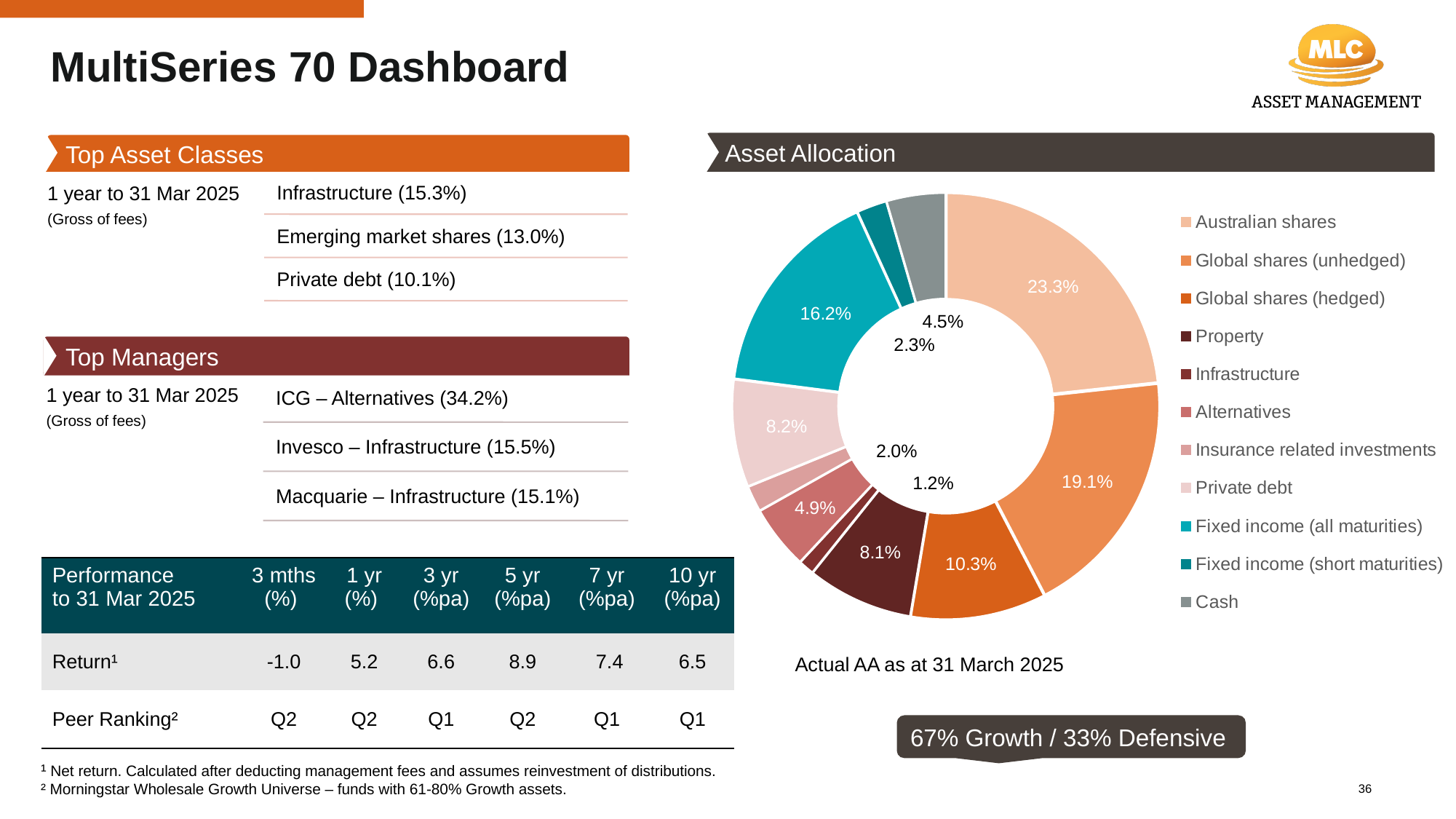
Which asset class has the largest allocation in the Asset Allocation chart? Australian shares What date is the asset allocation in the chart stated to be as at? 31 March 2025 In the Asset Allocation chart, what is the combined allocation to Australian shares, Global shares (unhedged) and Global shares (hedged)? 52.7% What kind of chart is shown under the Asset Allocation heading? Doughnut (pie) chart In the Asset Allocation chart, what share is allocated to Private debt? 8.2% In the Asset Allocation chart, what share is allocated to Australian shares? 23.3% In the Asset Allocation chart, what share is allocated to Global shares (hedged)? 10.3% In the Asset Allocation chart, what share is allocated to Fixed income (all maturities)? 16.2% In the Asset Allocation chart, what share is allocated to Global shares (unhedged)? 19.1% How many asset classes does the legend of the Asset Allocation chart list? 11 In the Asset Allocation chart, how much larger is the Australian shares allocation than the Global shares (unhedged) allocation? 4.2% In the Asset Allocation chart, which has the larger allocation: Global shares (hedged) or Fixed income (all maturities)? Fixed income (all maturities)